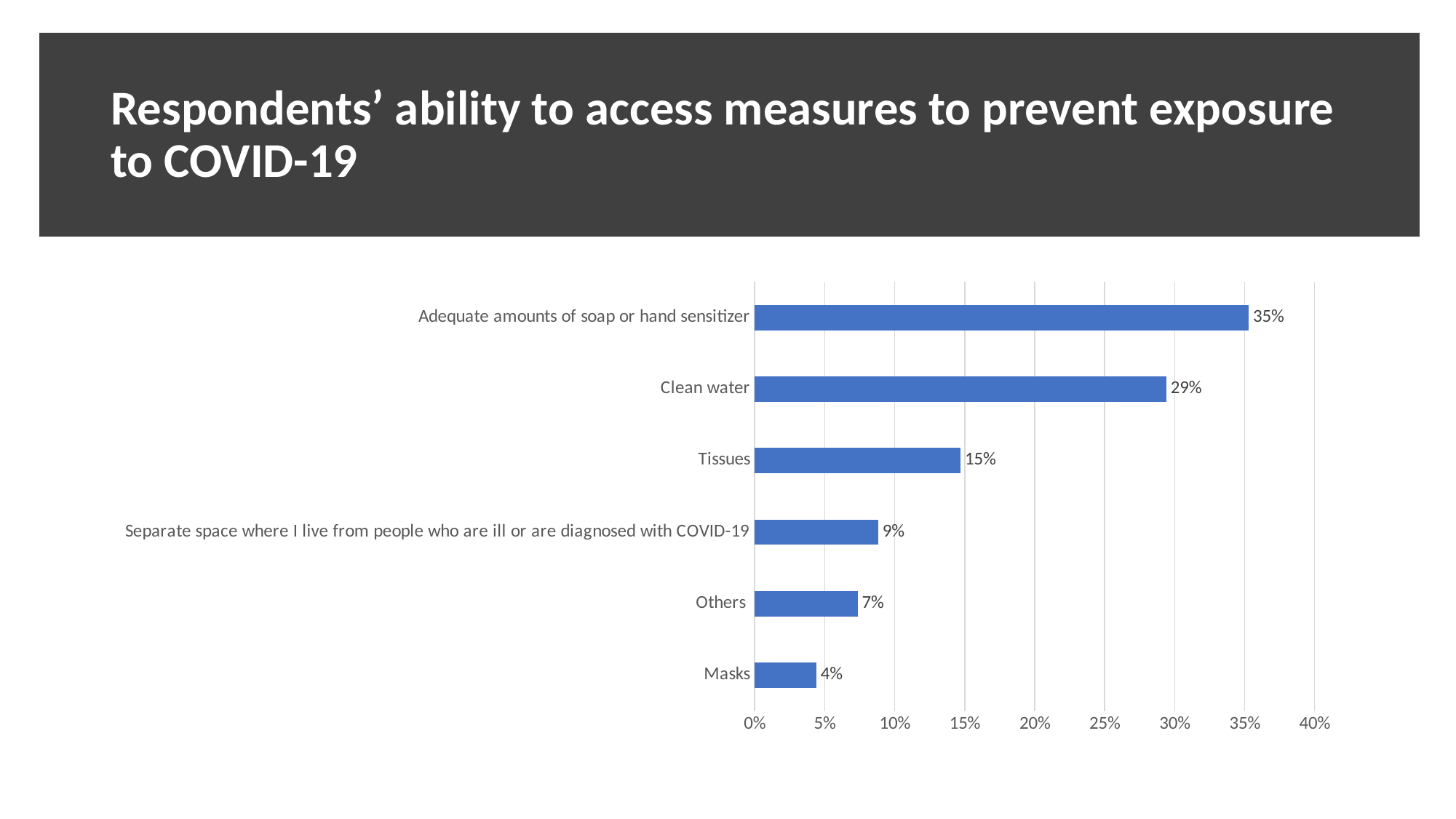
How many categories are shown in the chart? 6 What is the value for Clean water? 29% Which category has the highest value? Adequate amounts of soap or hand sensitizer What is the value for Masks? 4% Is the value for Separate space where I live from people who are ill or are diagnosed with COVID-19 greater or less than 10%? less What is the difference between the values for Clean water and Tissues? 14% Which category has the lowest value? Masks Which is larger, the value for Others or the value for Masks? Others What is the value for Tissues? 15% What is the title of the slide? Respondents' ability to access measures to prevent exposure to COVID-19 What percentage of respondents reported access to adequate amounts of soap or hand sensitizer? 35% What kind of chart is shown on the slide? Bar chart